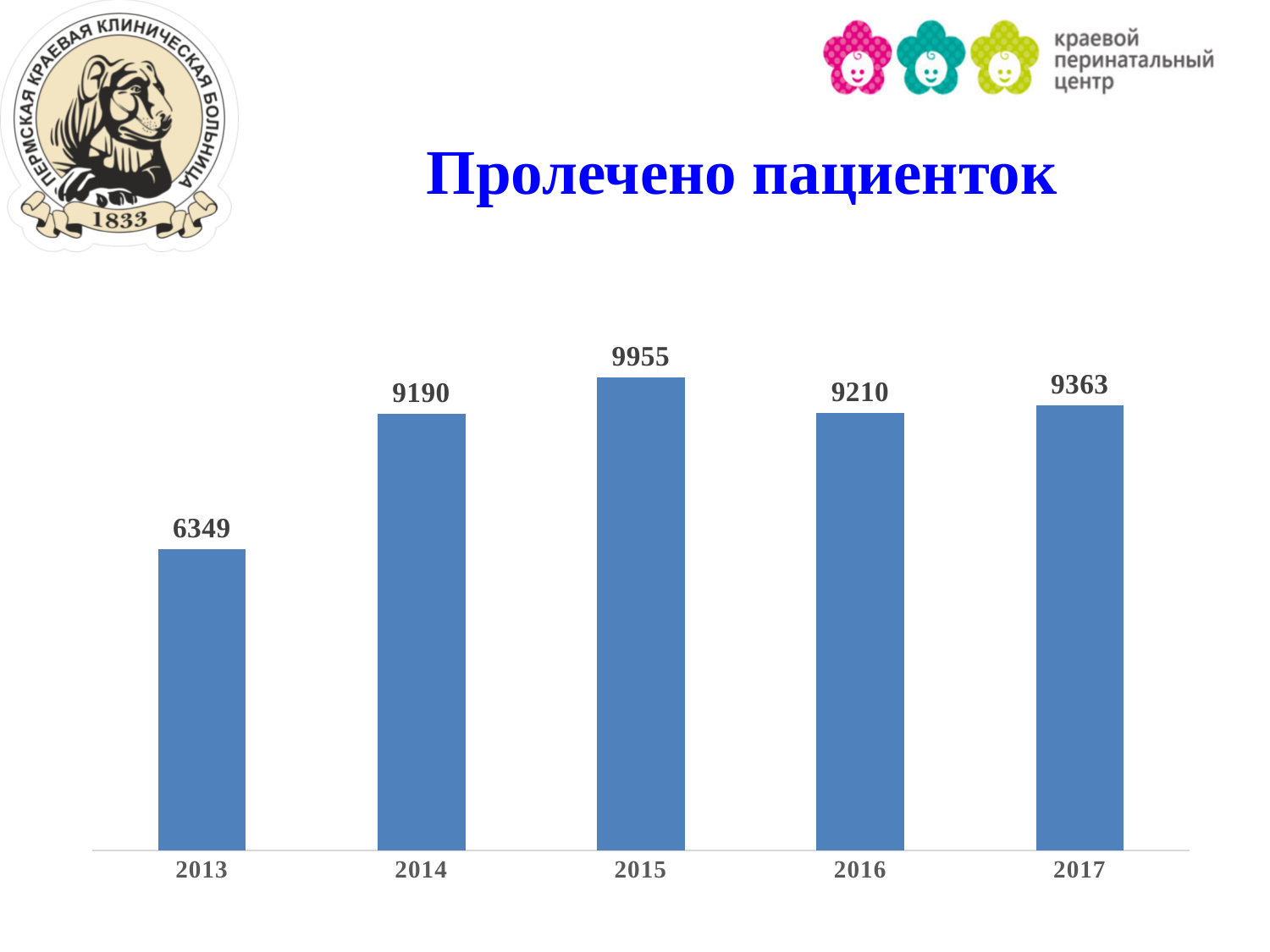
What is the difference between the values for 2015 and 2013? 3606 Which year has the lowest value? 2013 Which is larger, the value for 2014 or the value for 2017? 2017 What is the value for 2013? 6349 What is the value for 2017? 9363 How many years are shown on the chart? 5 Does the value rise or fall from 2013 to 2015? rise Which year has the highest value? 2015 What is the difference between the values for 2017 and 2016? 153 What kind of chart is shown on the slide? bar chart What is the title of the chart? Пролечено пациенток What is the value for 2015? 9955